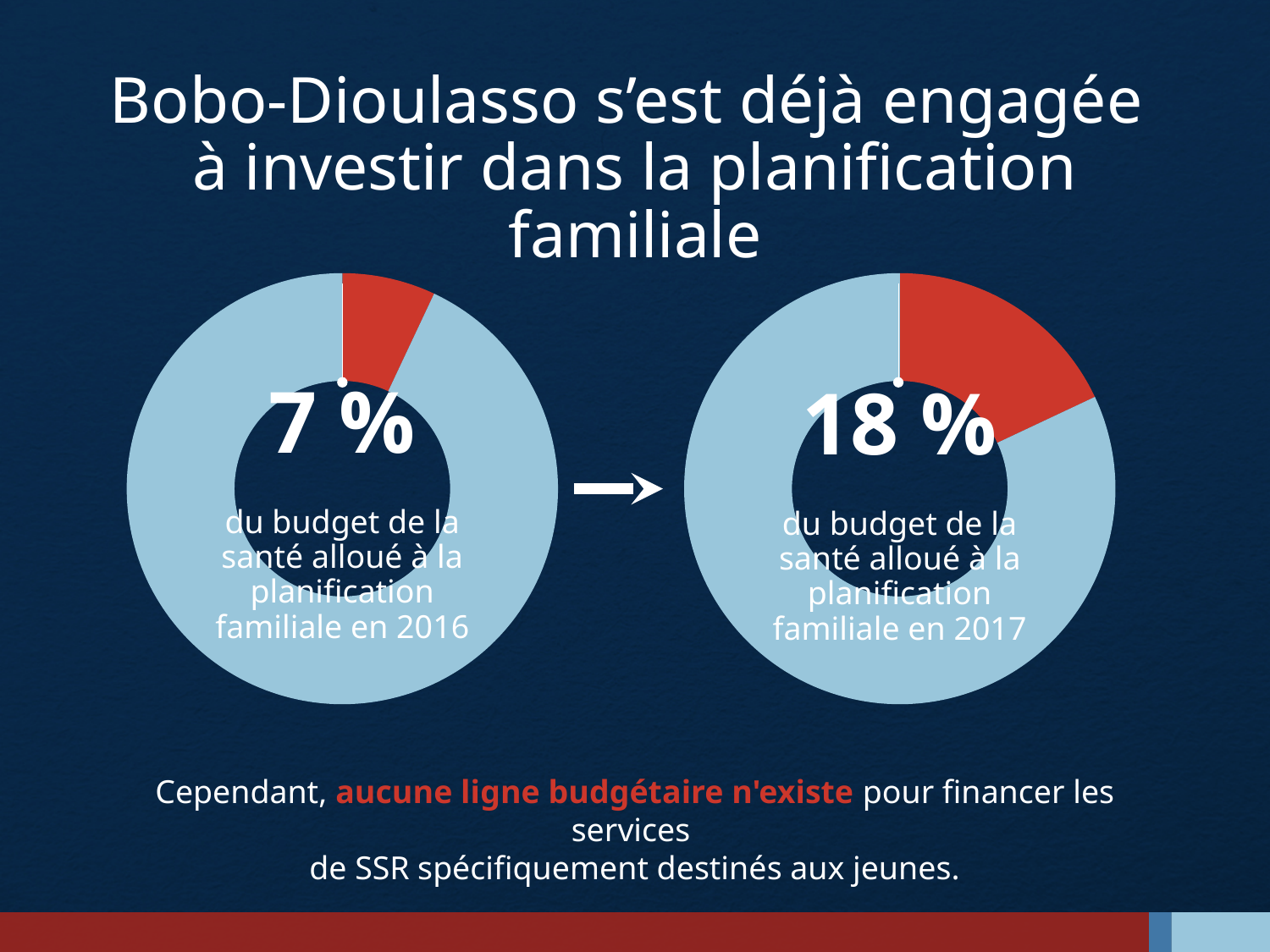
Is the 2017 share of the health budget allocated to family planning greater or less than 10 %? greater Which year shows the larger share of the health budget allocated to family planning, 2016 or 2017? 2017 Did the share of the health budget allocated to family planning rise or fall from 2016 to 2017? Rise How many donut charts are shown on the slide? 2 In the right donut chart, what share of the health budget was allocated to family planning in 2017? 18 % In the left donut chart, what share of the health budget was allocated to family planning in 2016? 7 % By how many percentage points did the share of the health budget allocated to family planning increase from 2016 to 2017? 11 What colour is used for the family planning slice in both donut charts? Red In the right donut chart, what share of the whole does the red slice represent? 18 % What kind of chart is used to show the budget shares on this slide? Donut (pie) chart How many slices does each donut chart contain? 2 In the left donut chart, what share of the whole does the red slice represent? 7 %